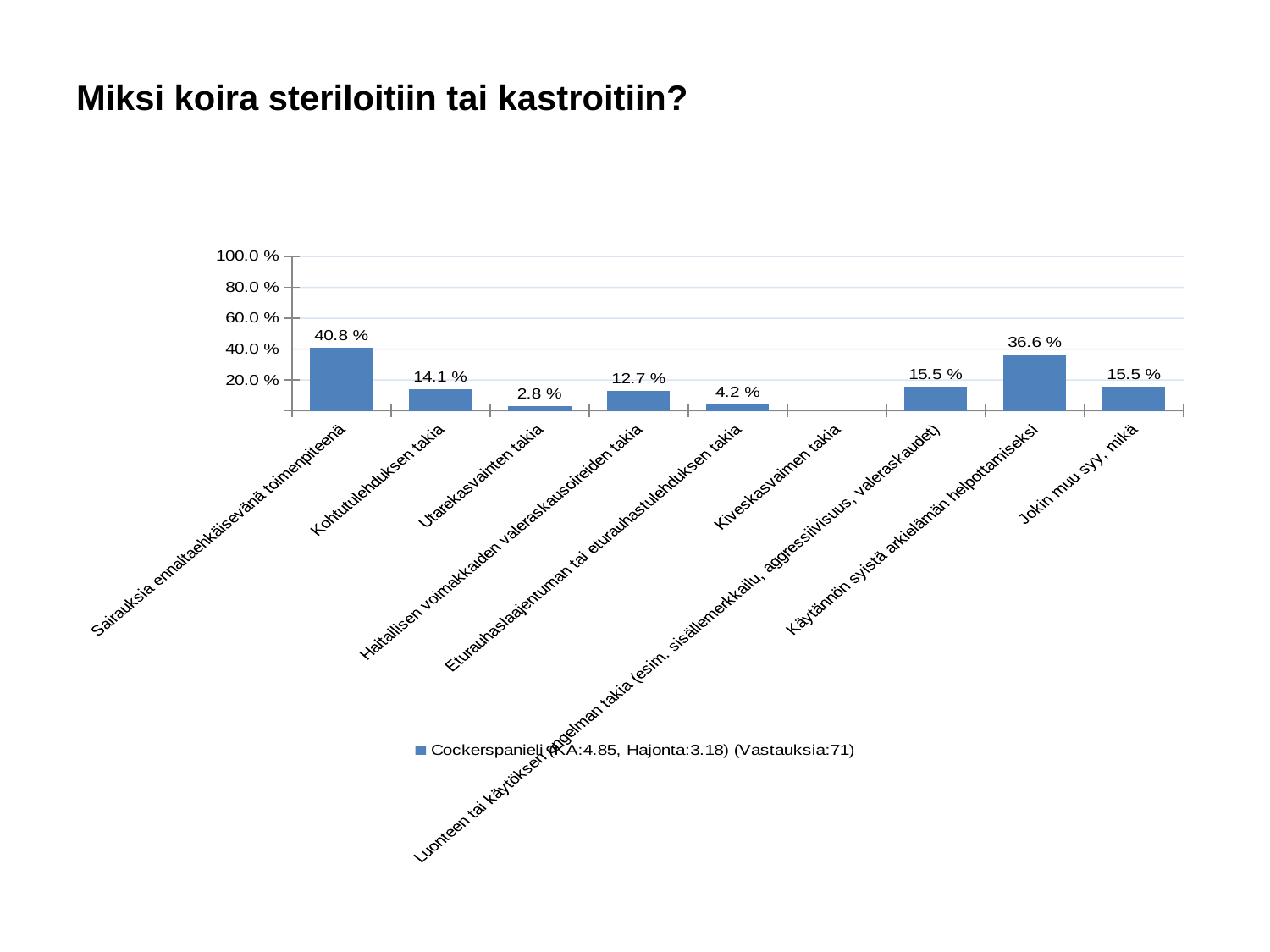
What is the value for Eturauhaslaajentuman tai eturauhastulehduksen takia? 4.2 % Is the value for Käytännön syistä arkielämän helpottamiseksi greater or less than 20.0 %? greater What is the difference between the values for Sairauksia ennaltaehkäisevänä toimenpiteenä and Käytännön syistä arkielämän helpottamiseksi? 4.2 % What is the value for Sairauksia ennaltaehkäisevänä toimenpiteenä? 40.8 % Which is larger, the value for Kohtutulehduksen takia or the value for Haitallisen voimakkaiden valeraskausoireiden takia? Kohtutulehduksen takia What kind of chart is shown on the slide? bar chart What is the title of the slide? Miksi koira steriloitiin tai kastroitiin? Which category has the highest value? Sairauksia ennaltaehkäisevänä toimenpiteenä What is the value for Utarekasvainten takia? 2.8 % What is the value for Kohtutulehduksen takia? 14.1 % What is the value for Käytännön syistä arkielämän helpottamiseksi? 36.6 % How many categories are shown on the x axis? 9